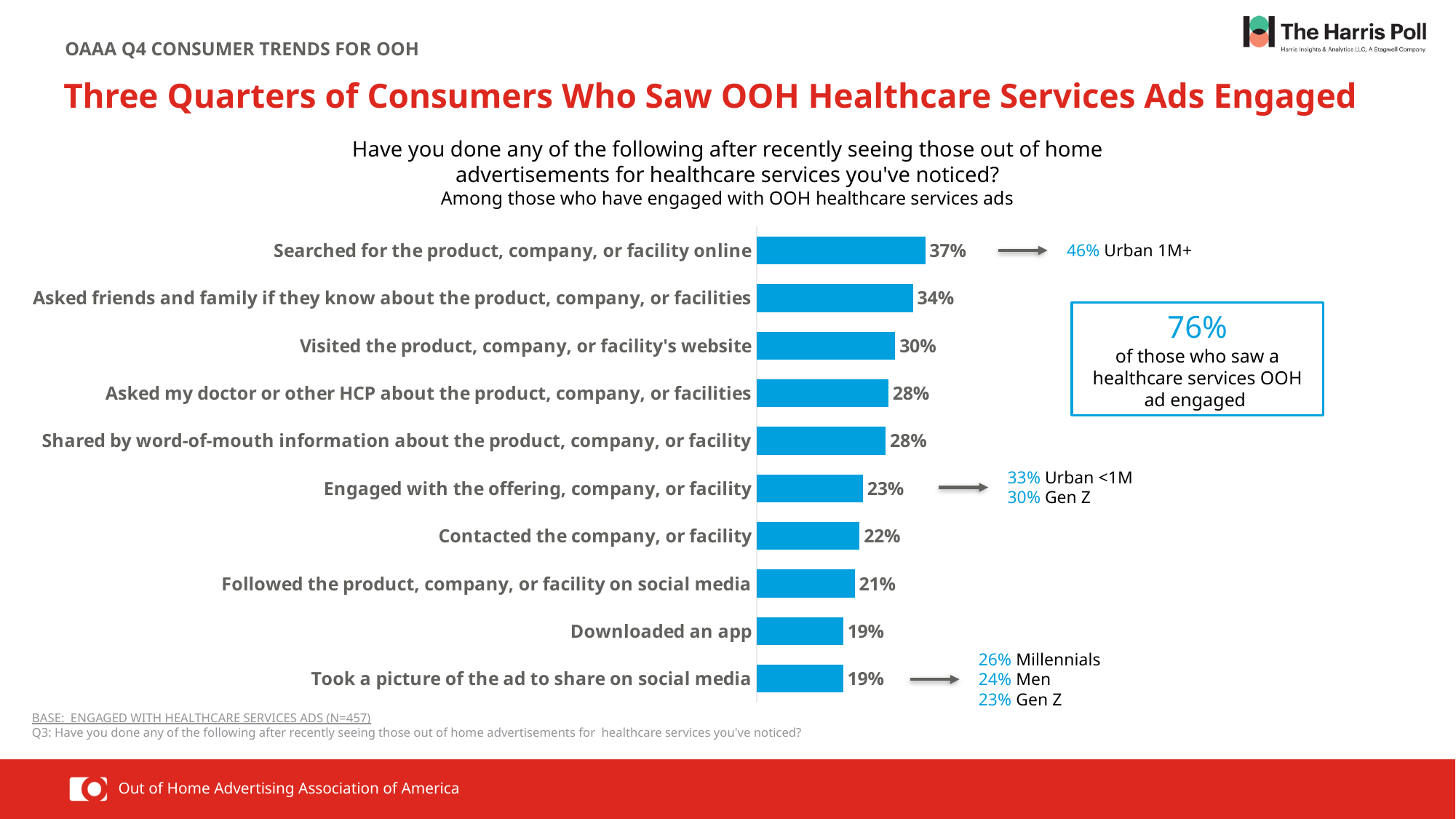
How many actions (categories) are shown in the bar chart? 10 What percentage of respondents downloaded an app? 19% According to the callout box, what percentage of those who saw a healthcare services OOH ad engaged? 76% What percentage of respondents visited the product, company, or facility's website? 30% What is the difference in percentage points between 'Engaged with the offering, company, or facility' and 'Took a picture of the ad to share on social media'? 4 percentage points What percentage of Urban 1M+ respondents searched for the product, company, or facility online, according to the annotation? 46% What percentage of respondents searched for the product, company, or facility online? 37% Which action has the highest percentage in the chart? Searched for the product, company, or facility online What type of chart is shown on the slide? Bar chart Which is larger: the percentage who contacted the company, or facility, or the percentage who followed the product, company, or facility on social media? Contacted the company, or facility What is the difference in percentage points between 'Searched for the product, company, or facility online' and 'Asked friends and family if they know about the product, company, or facilities'? 3 percentage points What percentage of respondents asked their doctor or other HCP about the product, company, or facilities? 28%